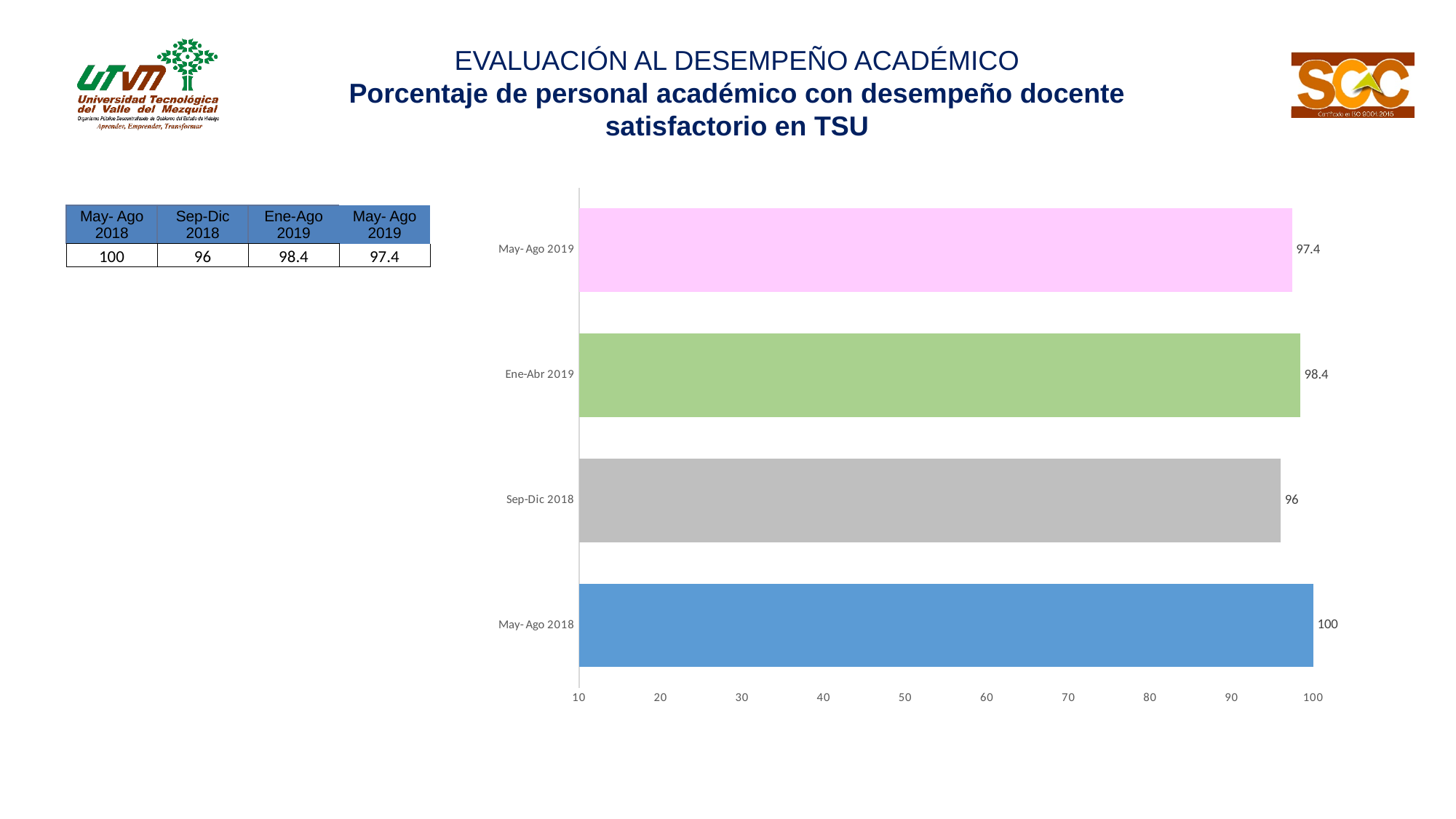
What is the difference between the values for Ene-Abr 2019 and May- Ago 2019? 1 What is the value for May- Ago 2019? 97.4 What is the difference between the values for May- Ago 2018 and Sep-Dic 2018? 4 What is the value for May- Ago 2018? 100 What type of chart is shown on the slide? bar chart Which period has the highest value? May- Ago 2018 What is the value for Ene-Abr 2019? 98.4 What colour is the bar for May- Ago 2018? blue Which period has the lowest value? Sep-Dic 2018 How many periods (bars) are plotted in the chart? 4 What is the value for Sep-Dic 2018? 96 Which is larger, the value for Ene-Abr 2019 or the value for Sep-Dic 2018? Ene-Abr 2019